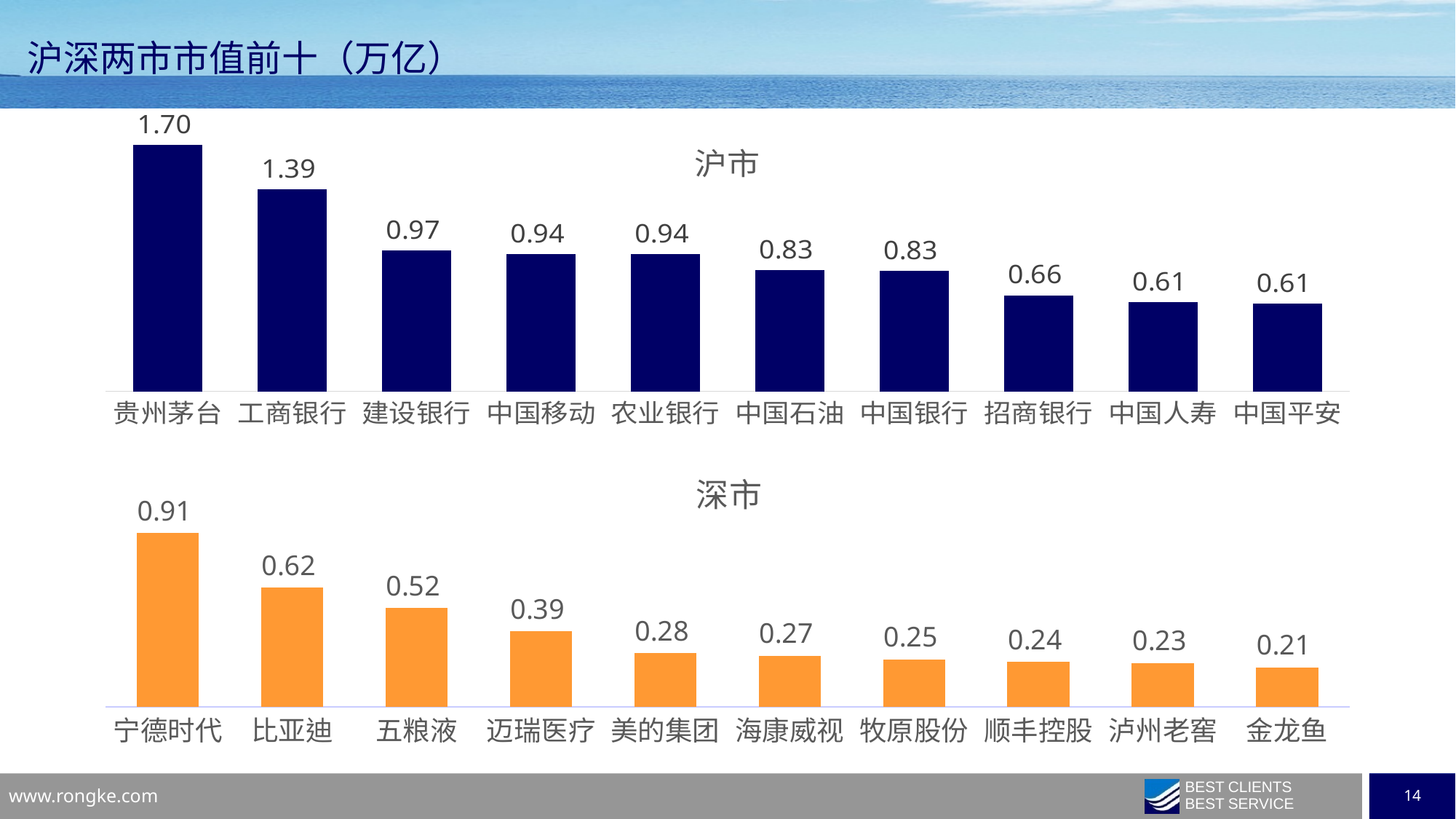
In the 沪市 chart, what is the value for 招商银行? 0.66 How many companies are shown in the 深市 chart? 10 In the 深市 chart, what is the value for 比亚迪? 0.62 In the 深市 chart, what is the difference between 宁德时代 and 五粮液? 0.39 In the 深市 chart, do the values rise or fall from left to right? fall In the 沪市 chart, what is the difference between 贵州茅台 and 工商银行? 0.31 In the 沪市 chart, which company has the highest value? 贵州茅台 In the 沪市 chart, what is the value for 贵州茅台? 1.70 What kind of chart is the 沪市 chart? bar chart In the 深市 chart, what is the value for 金龙鱼? 0.21 In the 深市 chart, which company has the lowest value? 金龙鱼 In the 深市 chart, which is larger, 迈瑞医疗 or 美的集团? 迈瑞医疗